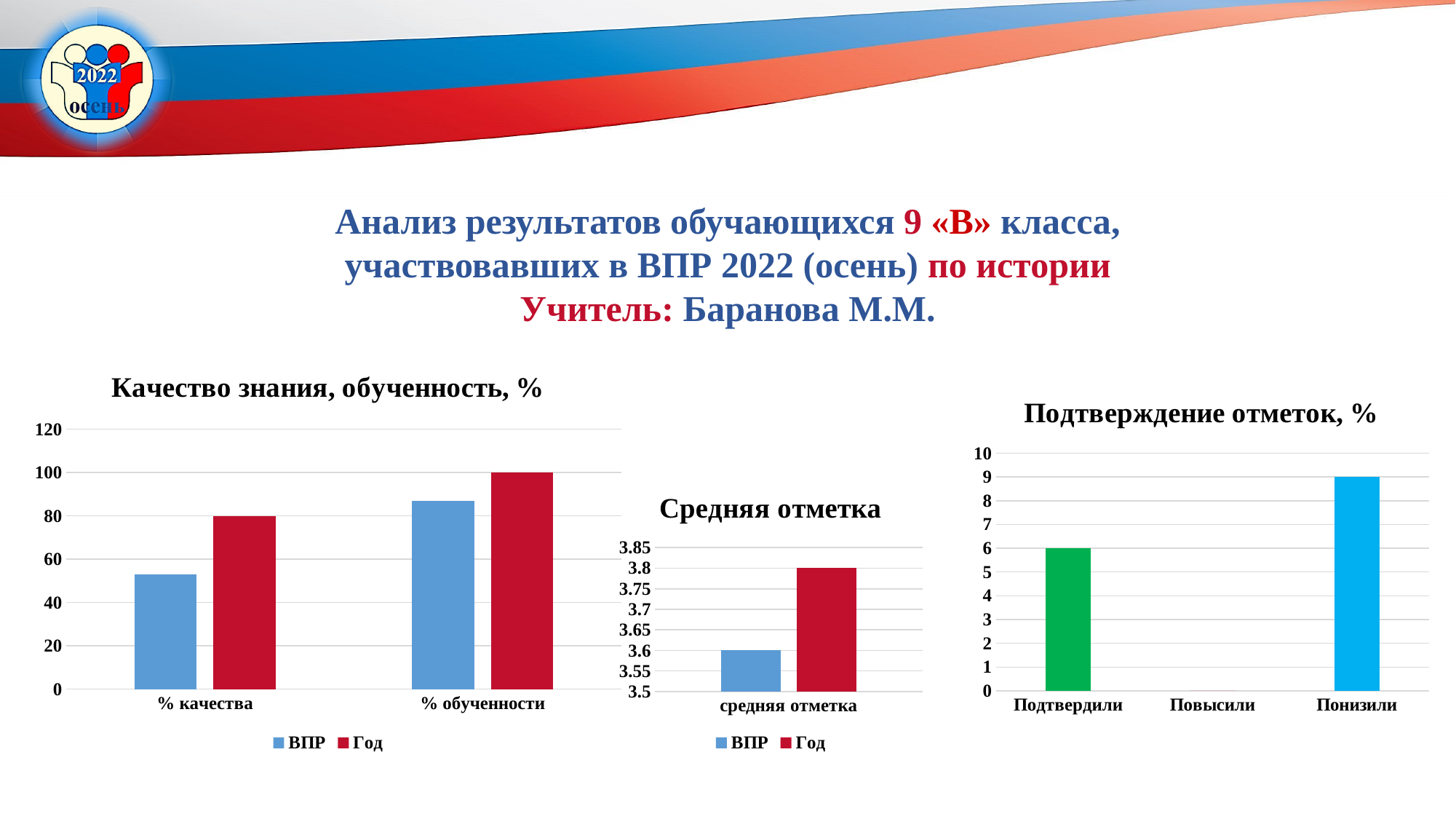
In the chart 'Средняя отметка', what is the value for 'Год'? 3.8 In the chart 'Качество знания, обученность, %', is the 'ВПР' value for '% качества' greater or less than 60? less How many series does the legend of the chart 'Качество знания, обученность, %' list? 2 In the chart 'Подтверждение отметок, %', what is the value for 'Подтвердили'? 6 In the chart 'Средняя отметка', what is the difference between the 'Год' value and the 'ВПР' value? 0.2 In the chart 'Средняя отметка', what is the value for 'ВПР'? 3.6 In the chart 'Качество знания, обученность, %', what is the value of the 'Год' series for '% обученности'? 100 In the chart 'Качество знания, обученность, %', what is the value of the 'Год' series for '% качества'? 80 In the chart 'Качество знания, обученность, %', which series has the larger value for '% качества', 'ВПР' or 'Год'? Год In the chart 'Подтверждение отметок, %', which category has the highest value? Понизили In the chart 'Качество знания, обученность, %', is the 'ВПР' value for '% обученности' greater or less than 80? greater In the chart 'Подтверждение отметок, %', how many categories are shown on the x axis? 3